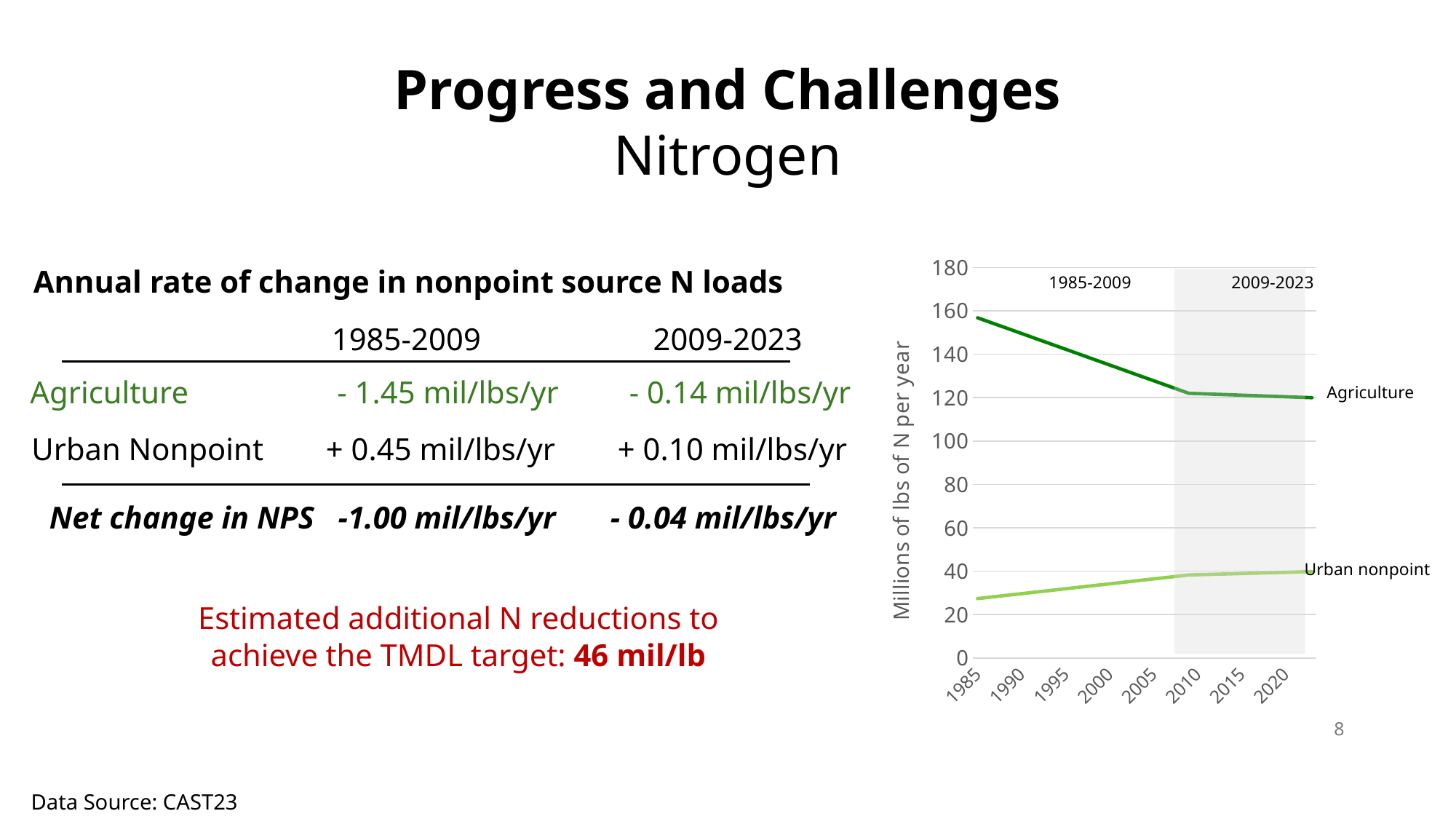
What is the highest value shown on the y axis of the line chart? 180 Which two series are labelled in the line chart? Agriculture and Urban nonpoint Is the Agriculture value in 1985 greater or less than 140? greater Is the Agriculture value in 2020 greater or less than 100? greater What is the label of the y axis in the line chart? Millions of lbs of N per year Does the Urban nonpoint line rise or fall from 1985 to 2023? rise Is the Urban nonpoint value in 1985 greater or less than 40? less Does the Agriculture line rise or fall from 1985 to 2023? fall How many series are plotted in the line chart? 2 Which series has the higher values throughout the chart, Agriculture or Urban nonpoint? Agriculture What kind of chart is shown on the right of the slide? line chart